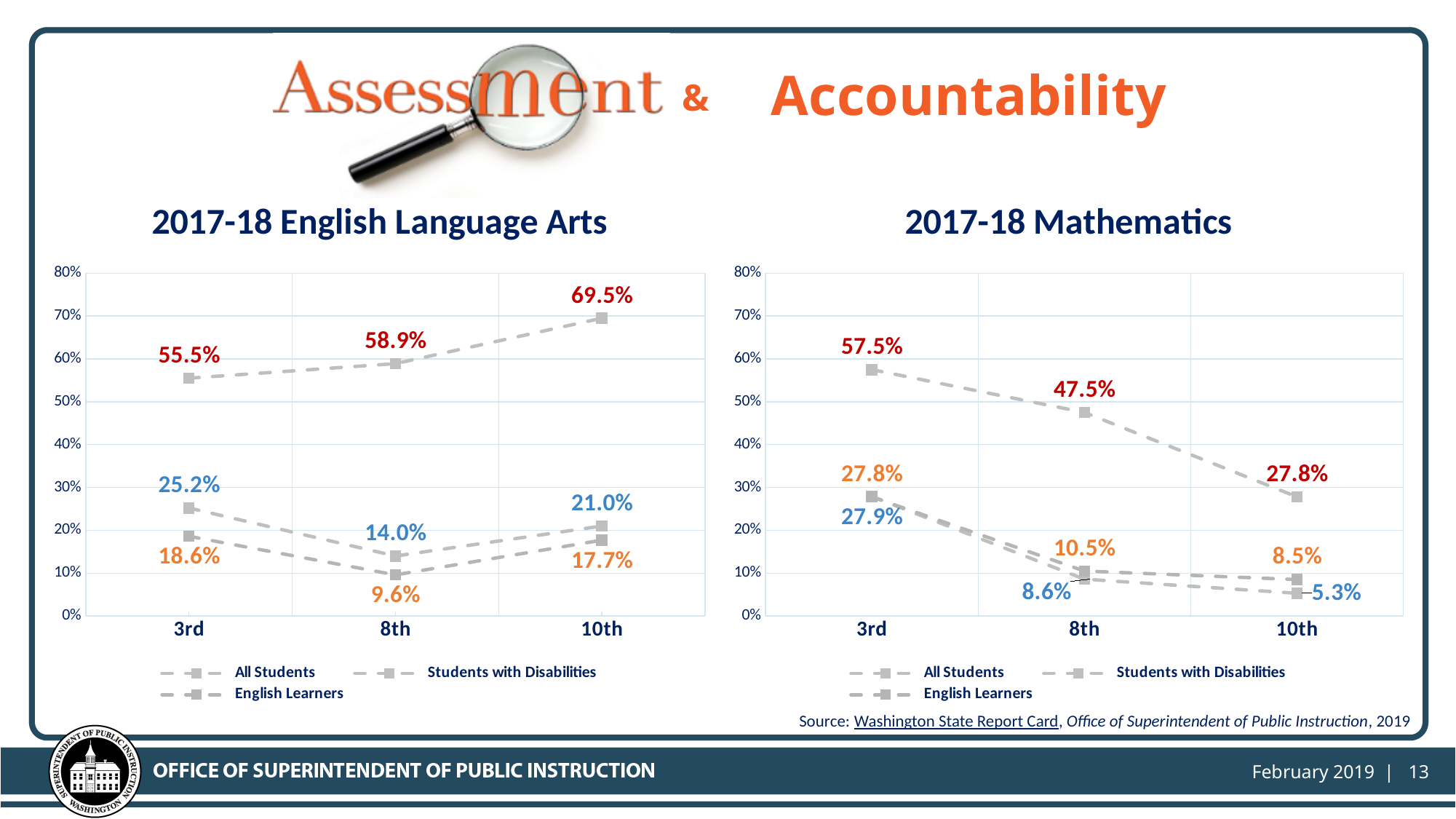
In the 2017-18 Mathematics chart, what is the highest value shown for 3rd grade? 57.5% In the 2017-18 English Language Arts chart, what is the highest value shown for 3rd grade? 55.5% In the 2017-18 English Language Arts chart, what is the difference between the top line's 10th grade value (69.5%) and its 3rd grade value (55.5%)? 14.0 percentage points In the 2017-18 Mathematics chart, what is the lowest value shown for 10th grade? 5.3% How many grade levels are shown on the x axis of the 2017-18 Mathematics chart? 3 In the 2017-18 English Language Arts chart, does the top line rise or fall from 3rd grade to 10th grade? Rise Which is larger: the highest 8th grade value in the 2017-18 English Language Arts chart or the highest 8th grade value in the 2017-18 Mathematics chart? English Language Arts (58.9%) What kind of chart is the 2017-18 Mathematics chart? Line chart In the 2017-18 Mathematics chart, does the top line rise or fall from 3rd grade to 10th grade? Fall In the 2017-18 English Language Arts chart, what is the lowest value shown for 8th grade? 9.6% In the 2017-18 English Language Arts chart, what is the highest value shown for 10th grade? 69.5% How many series does the legend of the 2017-18 English Language Arts chart list? 3